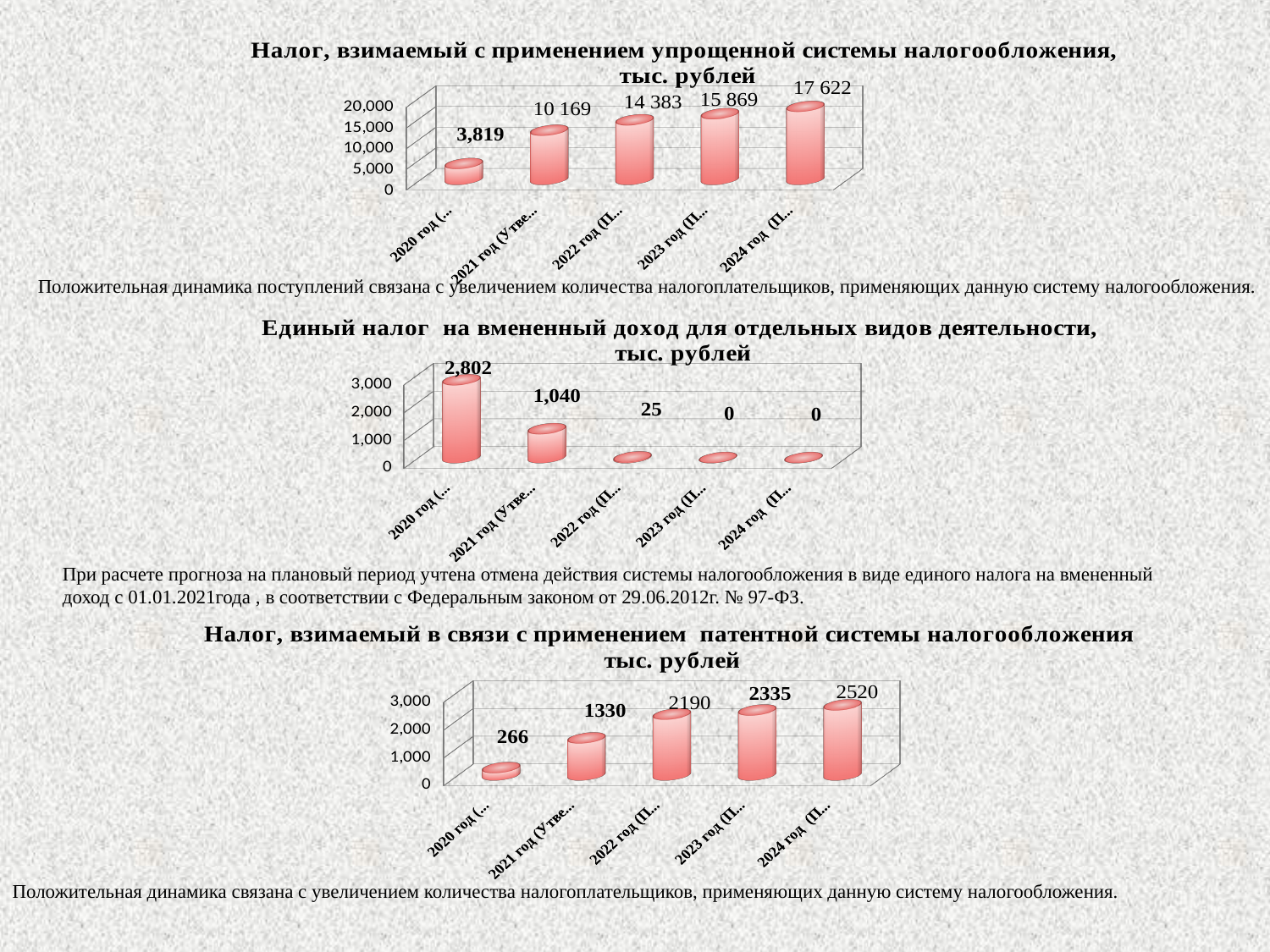
In the middle chart (Единый налог на вмененный доход), what is the value for 2022 год? 25 In the bottom chart (Налог, взимаемый в связи с применением патентной системы налогообложения), what is the value for 2023 год? 2335 In the middle chart (Единый налог на вмененный доход), what is the value for 2021 год? 1,040 In the bottom chart (Налог, взимаемый в связи с применением патентной системы налогообложения), what is the difference between the values for 2024 год and 2020 год? 2254 In the middle chart (Единый налог на вмененный доход), what is the difference between the values for 2020 год and 2021 год? 1,762 What type of chart is the bottom chart (Налог, взимаемый в связи с применением патентной системы налогообложения)? bar chart In the top chart (Налог, взимаемый с применением упрощенной системы налогообложения), what is the value for 2020 год? 3,819 In the middle chart (Единый налог на вмененный доход), which year has the highest value? 2020 год In the top chart (Налог, взимаемый с применением упрощенной системы налогообложения), do the values rise or fall from 2020 to 2024? rise In the top chart (Налог, взимаемый с применением упрощенной системы налогообложения), which year has the lowest value? 2020 год In the top chart (Налог, взимаемый с применением упрощенной системы налогообложения), what is the value for 2024 год? 17 622 In the bottom chart (Налог, взимаемый в связи с применением патентной системы налогообложения), how many years are plotted? 5